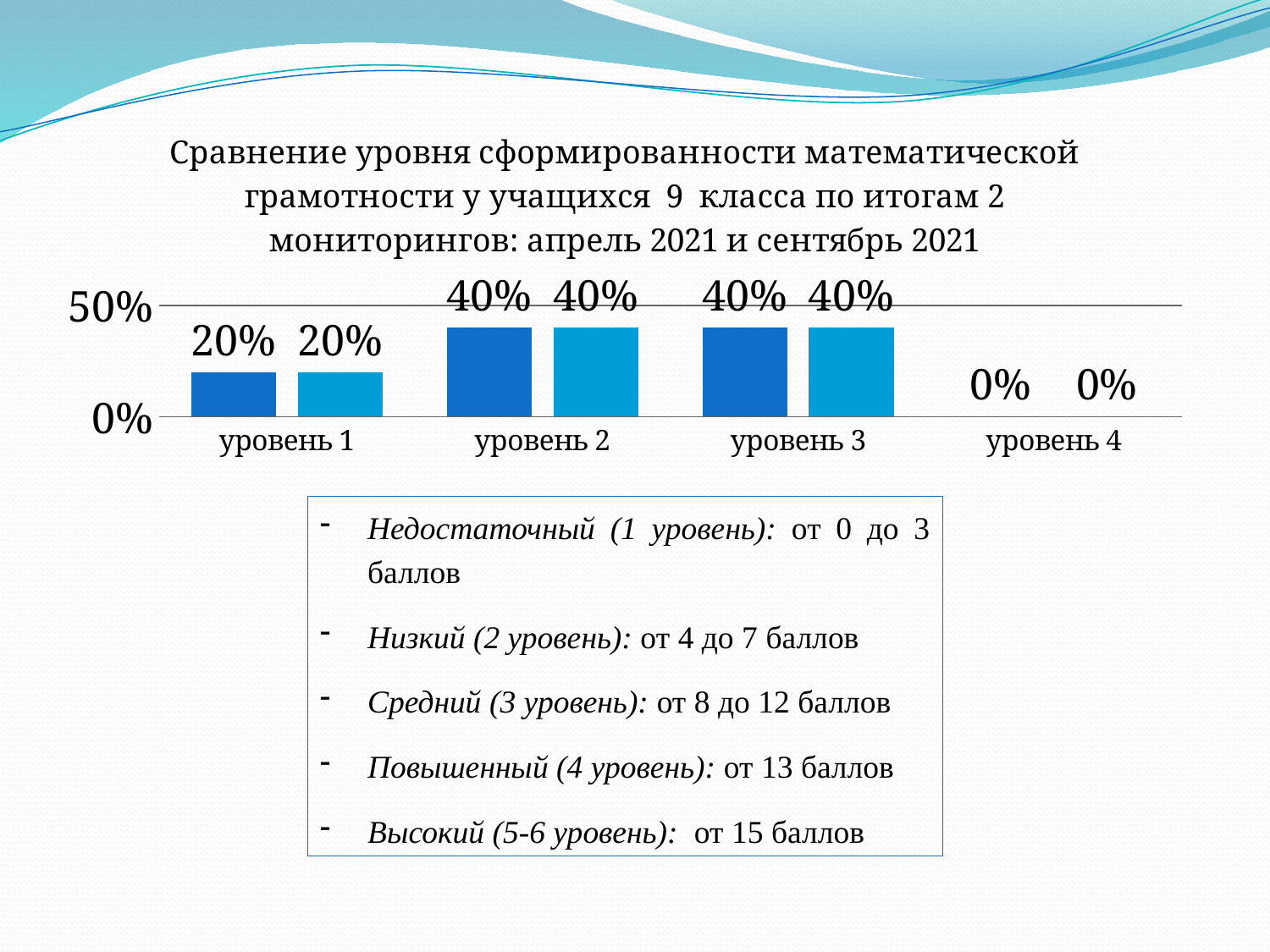
Which is larger: the light blue bar for уровень 3 or the light blue bar for уровень 1? уровень 3 How many bars are plotted for each level in the chart? 2 How many categories (levels) are shown on the x axis of the chart? 4 Which level has the lowest values in the chart? уровень 4 Is the value of the dark blue bar for уровень 2 greater or less than 50%? less What is the value of the light blue bar for уровень 2? 40% What is the value of the dark blue bar for уровень 1? 20% What is the value of the dark blue bar for уровень 3? 40% What is the value of the light blue bar for уровень 4? 0% What is the highest value shown on the chart's vertical axis? 50% What type of chart is shown on the slide? bar chart What is the difference between the dark blue bar for уровень 2 and the dark blue bar for уровень 1? 20%